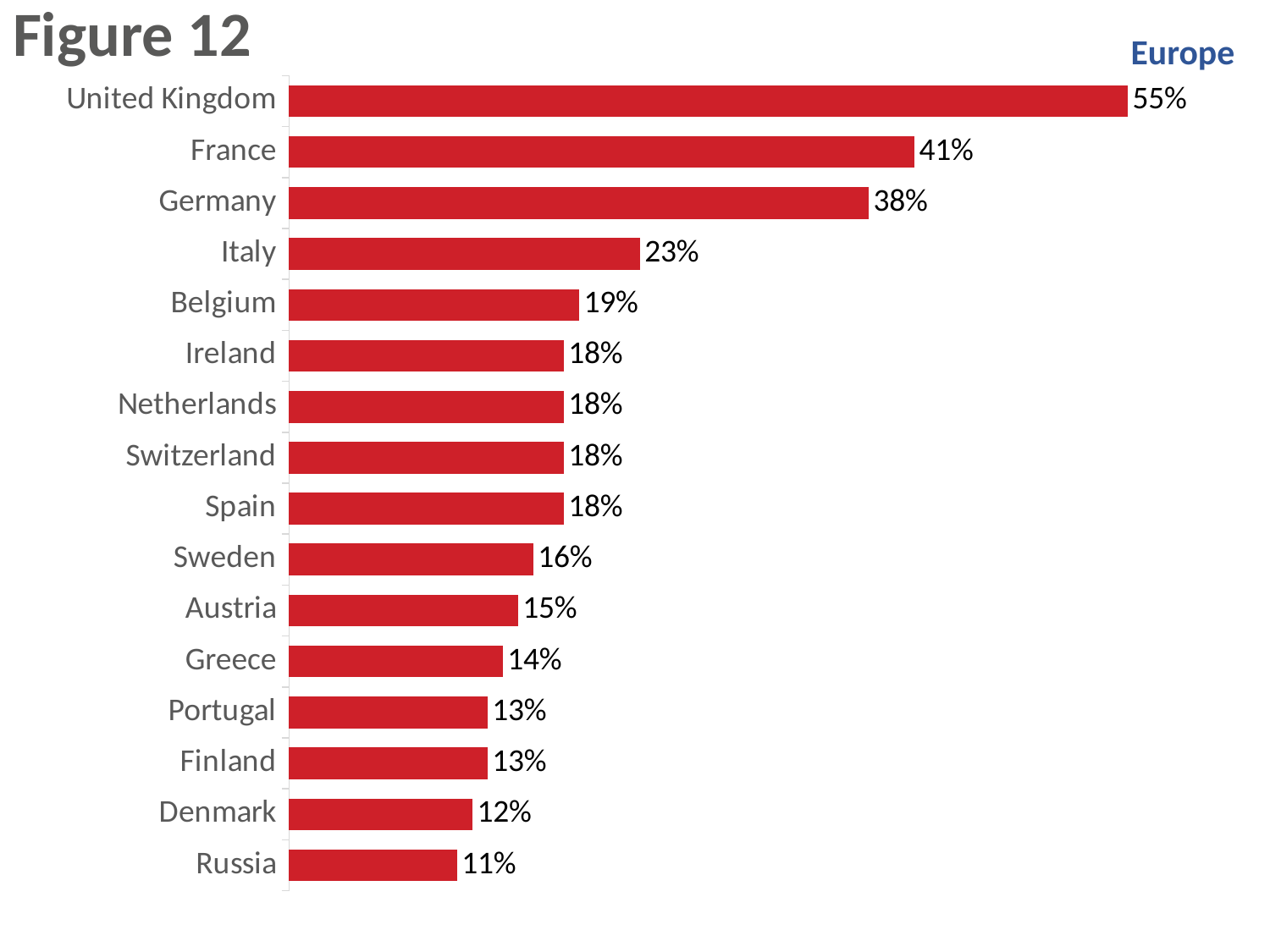
What is the difference between the values for the United Kingdom and Russia? 44% What is the difference between the values for France and Italy? 18% Which country has the lowest value? Russia Which is larger, the value for Belgium or the value for Austria? Belgium What is the value for Germany? 38% Which country has the highest value? United Kingdom What kind of chart is shown on the slide? Bar chart What is the value for Sweden? 16% Which is larger, the value for Germany or the value for France? France What is the value for the United Kingdom? 55% How many countries are shown in the chart? 16 What label appears in blue at the top right of the chart? Europe